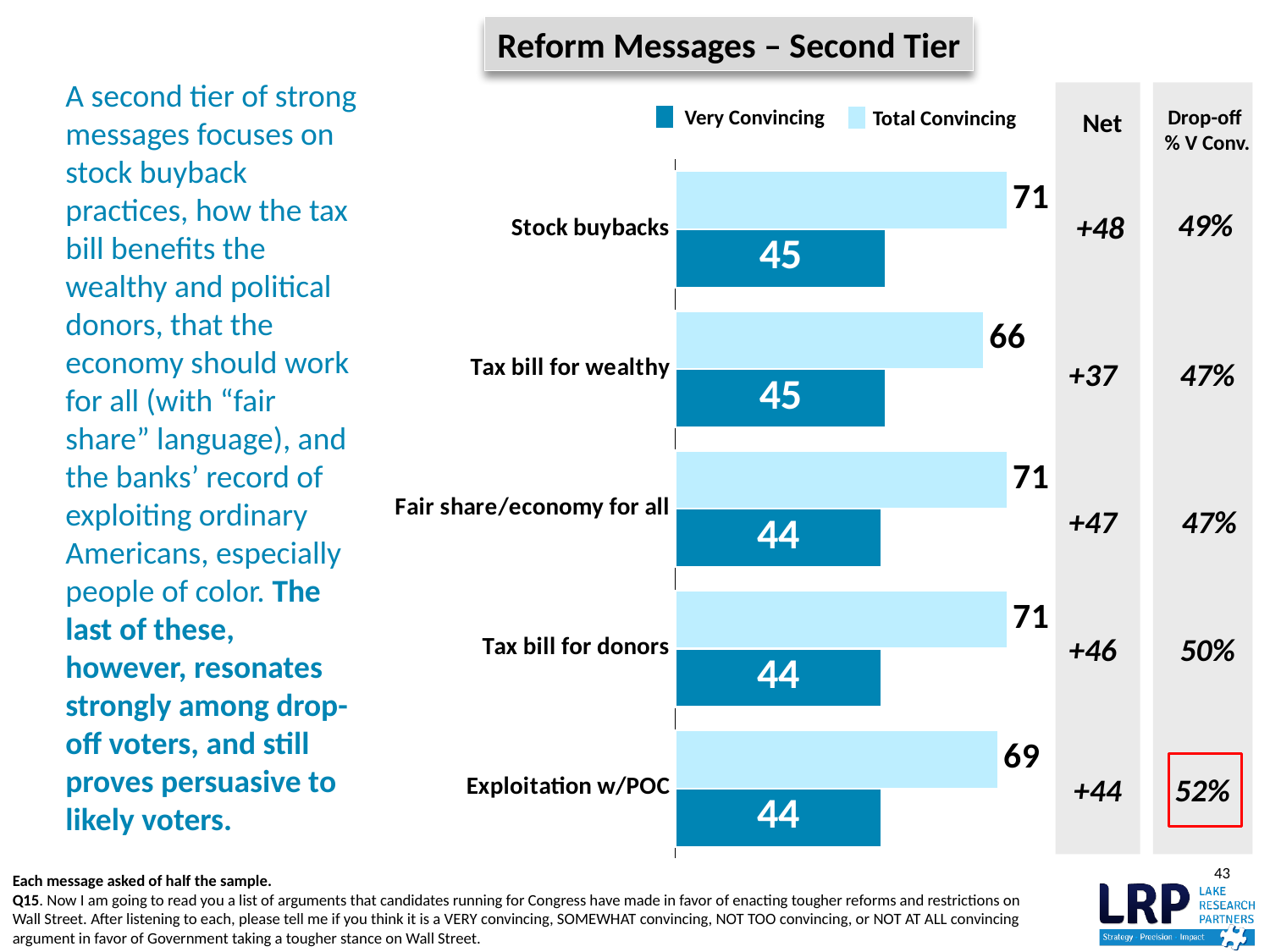
Which has a larger Total Convincing value, Stock buybacks or Tax bill for wealthy? Stock buybacks What is the Very Convincing value for Fair share/economy for all? 44 What is the Very Convincing value for Tax bill for wealthy? 45 Which message has the lowest Total Convincing value? Tax bill for wealthy What is the Total Convincing value for Stock buybacks? 71 How many series does the legend list? 2 How many messages are shown in the chart? 5 What kind of chart is shown on the slide? Bar chart What is the difference between the Total Convincing and Very Convincing values for Stock buybacks? 26 What is the Total Convincing value for Exploitation w/POC? 69 What is the difference between the Total Convincing and Very Convincing values for Tax bill for wealthy? 21 What is the title of the chart? Reform Messages – Second Tier